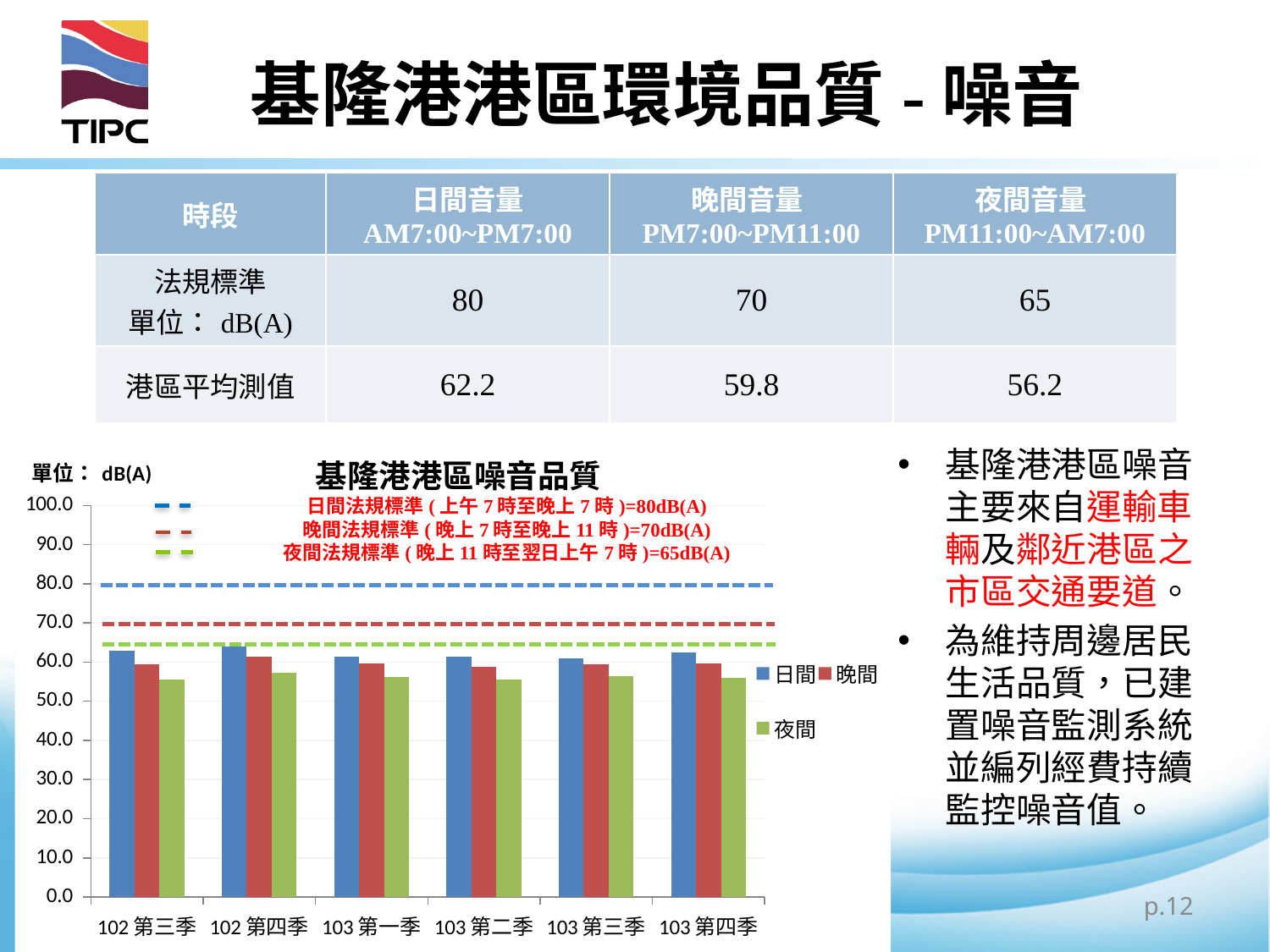
Is the 夜間 value for 102 第三季 greater or less than 50? greater How many quarters (categories) are shown on the x axis of the 基隆港港區噪音品質 chart? 6 Is the 晚間 value for 103 第三季 greater or less than 70? less According to the annotation on the chart, what is the daytime regulatory standard (日間法規標準) shown by the blue dashed line? 80dB(A) In 103 第一季, which is larger, the 日間 value or the 夜間 value? 日間 In 102 第四季, which is larger, the 晚間 value or the 夜間 value? 晚間 What type of chart is shown under the title 基隆港港區噪音品質? bar chart How many series does the legend of the 基隆港港區噪音品質 chart list? 3 What unit is stated for the values in the 基隆港港區噪音品質 chart? dB(A) Is the 日間 value for 102 第四季 greater or less than 70? less What are the three series listed in the legend of the 基隆港港區噪音品質 chart? 日間, 晚間, 夜間 According to the annotation on the chart, what is the night-time regulatory standard (夜間法規標準) shown by the green dashed line? 65dB(A)